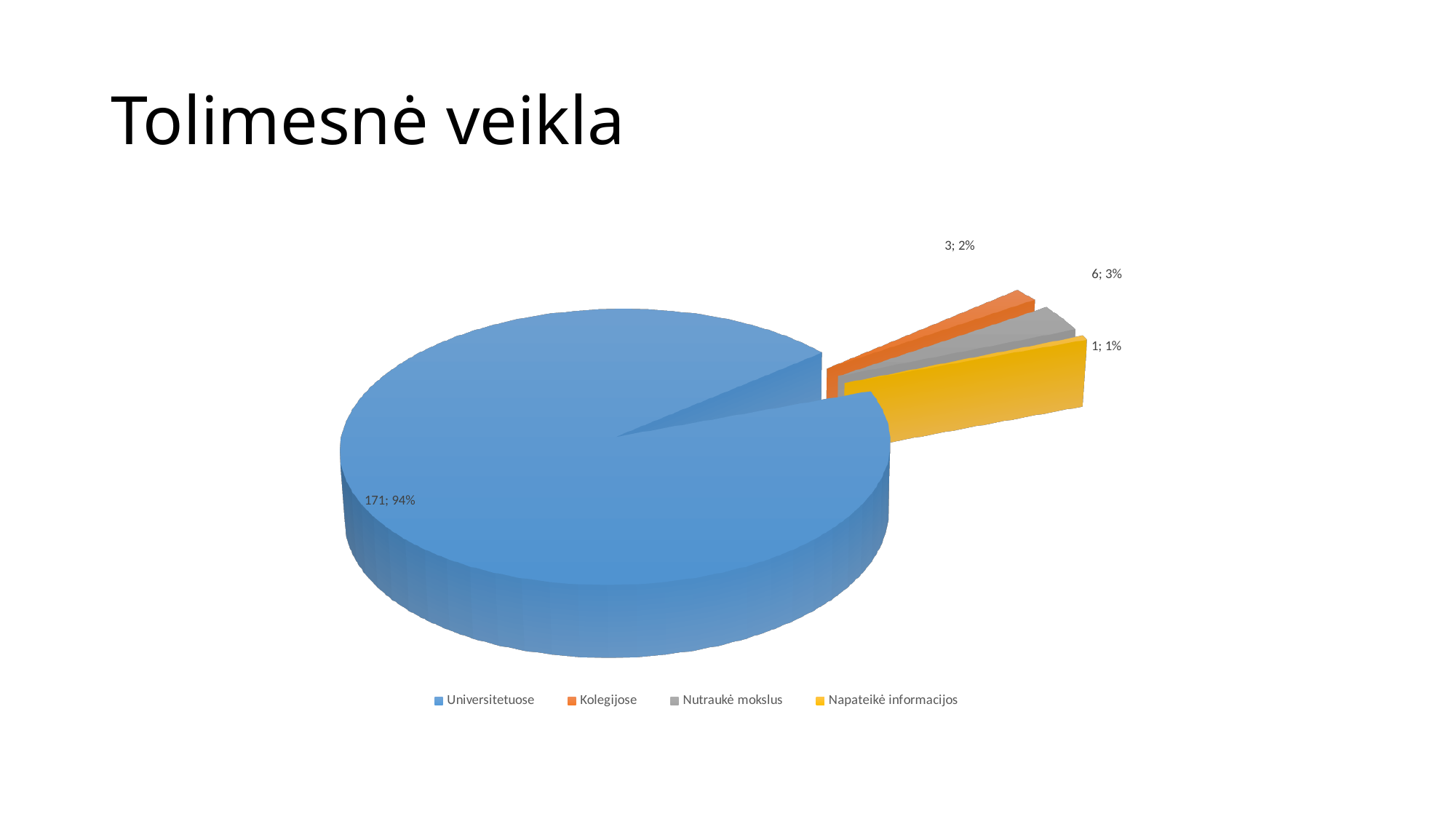
How many slices does the pie chart have? 4 How many entries does the legend list? 4 What percentage share does Universitetuose have? 94% Which category has the largest slice? Universitetuose What percentage share does Kolegijose have? 2% What is the title of the slide? Tolimesnė veikla What kind of chart is shown on the slide? Pie chart What value is shown for Universitetuose? 171 Which category has the smallest slice? Napateikė informacijos Which is larger, the value for Kolegijose or the value for Nutraukė mokslus? Nutraukė mokslus What value is shown for Nutraukė mokslus? 6 What is the difference between the values for Nutraukė mokslus and Kolegijose? 3